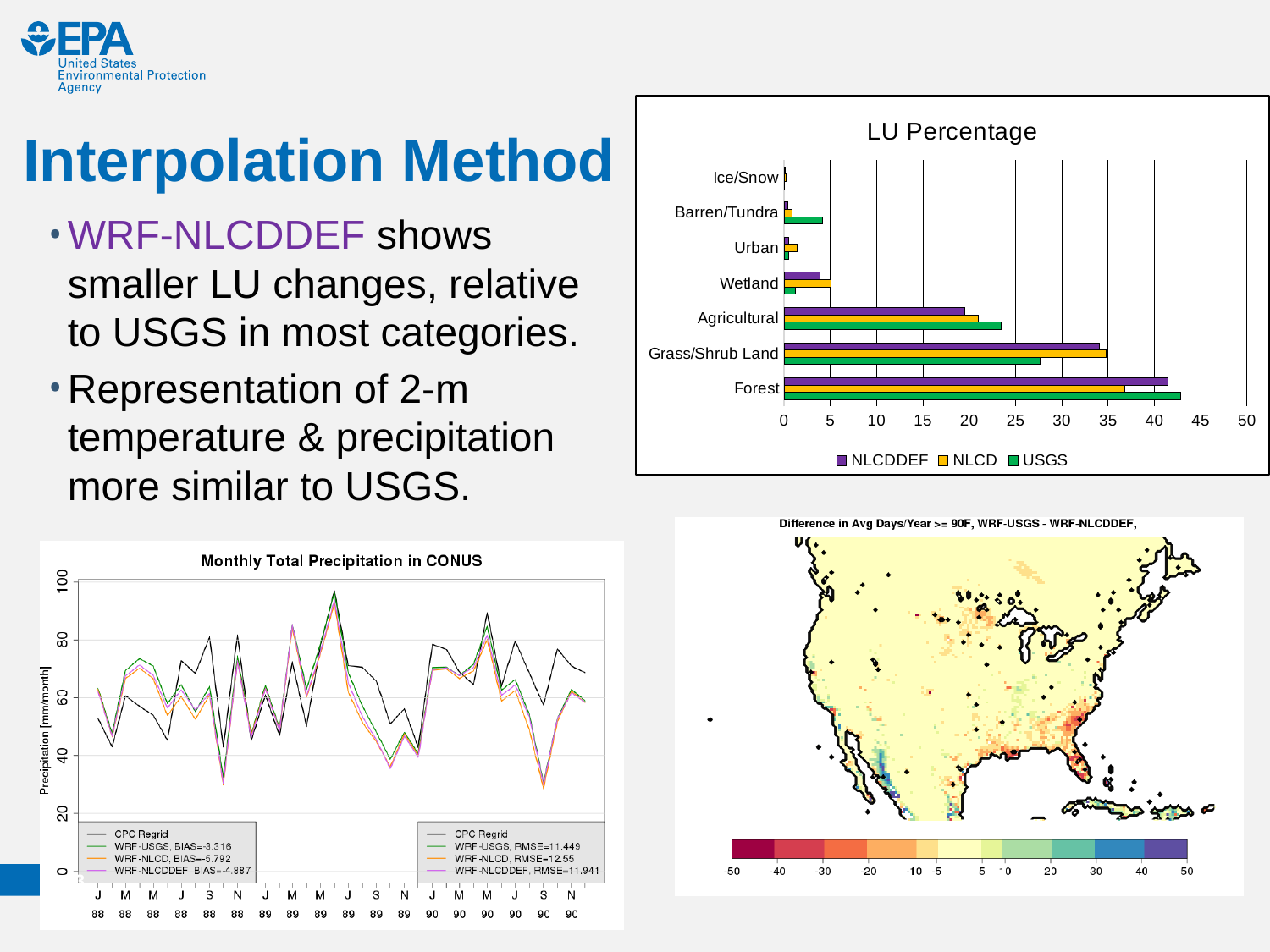
In the LU Percentage chart, is the USGS value for Forest greater or less than 40? greater In the LU Percentage chart, which category has the highest USGS value? Forest In the Monthly Total Precipitation in CONUS chart, what RMSE value is listed for WRF-USGS in the legend? 11.449 In the LU Percentage chart, how many land-use categories are shown on the vertical axis? 7 In the LU Percentage chart, is the USGS value for Agricultural greater or less than 20? greater In the LU Percentage chart, what kind of chart is it? bar chart In the LU Percentage chart, for Grass/Shrub Land, which is larger: the NLCD value or the USGS value? NLCD In the Monthly Total Precipitation in CONUS chart, what kind of chart is it? line chart In the LU Percentage chart, how many series does the legend list? 3 In the LU Percentage chart, is the USGS value for Grass/Shrub Land greater or less than 30? less In the LU Percentage chart, for Forest, which is larger: the NLCDDEF value or the NLCD value? NLCDDEF In the LU Percentage chart, which category has the lowest values across all three series? Ice/Snow